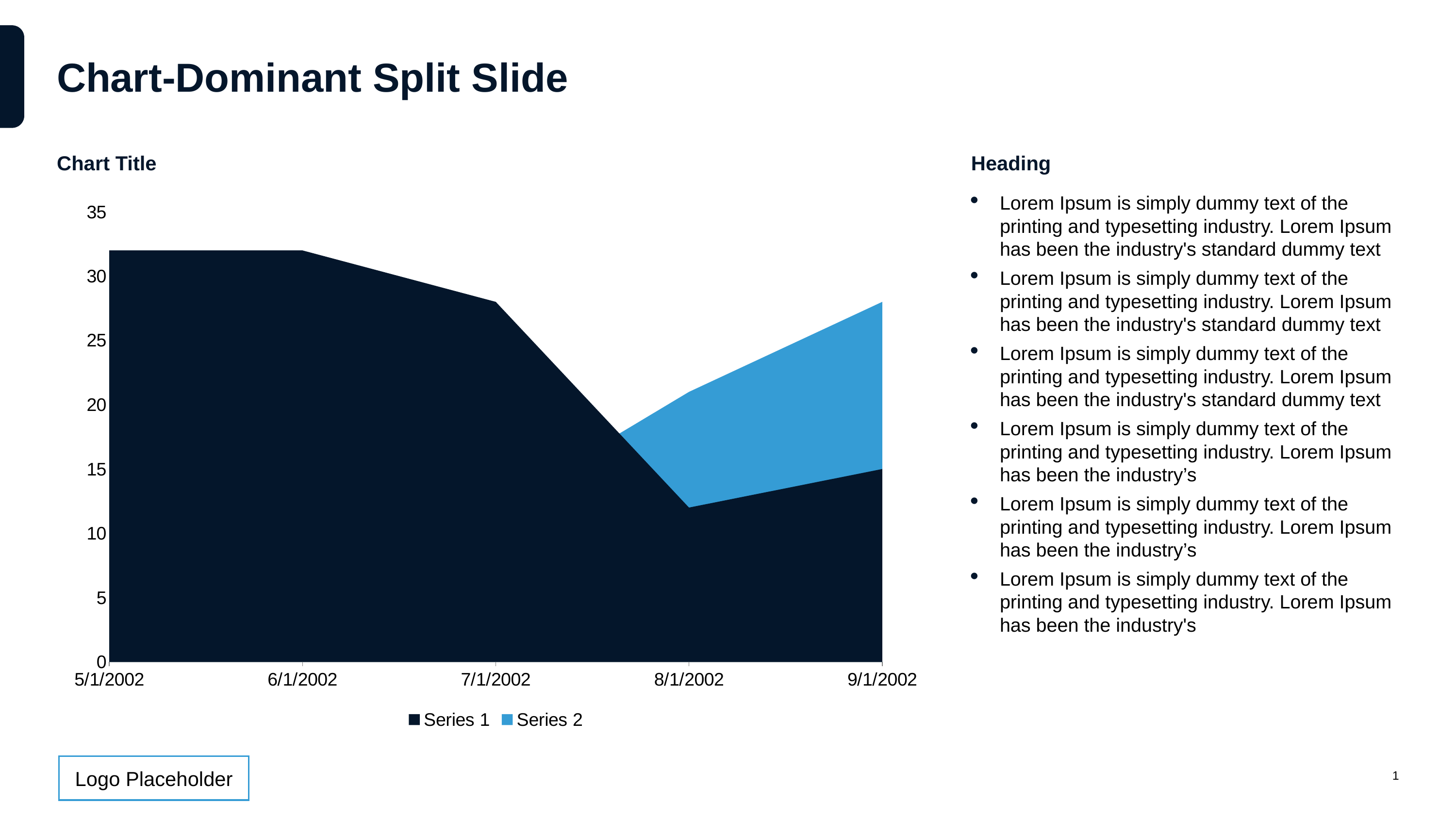
What kind of chart is shown on the slide? Area chart Is the value for Series 2 at 8/1/2002 greater or less than 25? less Does Series 1 rise or fall from 5/1/2002 to 8/1/2002? Fall At which date is Series 1 lowest? 8/1/2002 Is the value for Series 2 at 9/1/2002 greater or less than 25? greater How many series does the legend list? 2 Which is larger for Series 1: the value at 5/1/2002 or the value at 8/1/2002? 5/1/2002 Is the value for Series 1 at 7/1/2002 greater or less than 25? greater At 9/1/2002, which series has the larger value? Series 2 How many dates are shown on the x axis? 5